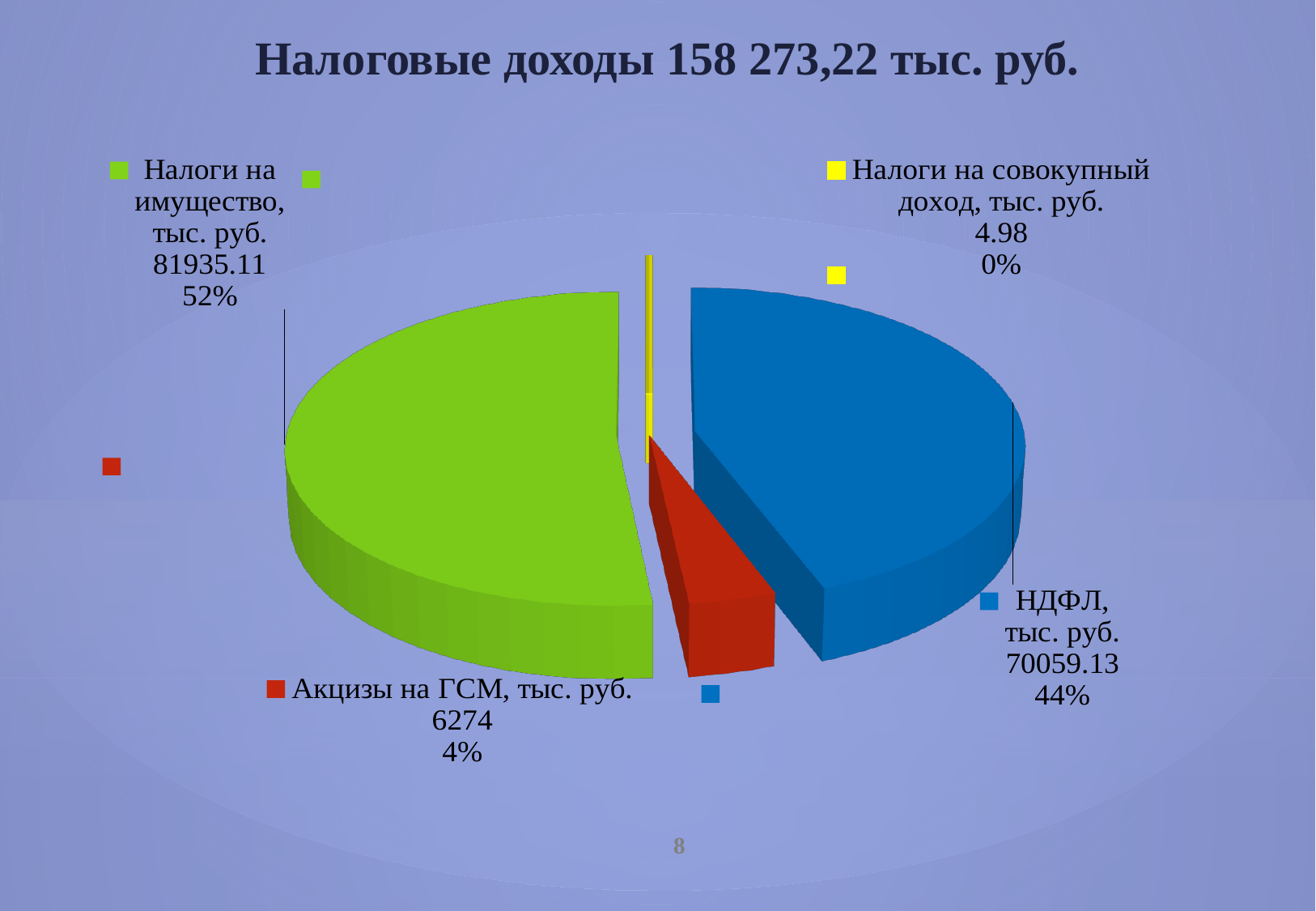
Which category has the smallest slice of the pie? Налоги на совокупный доход What is the value shown for Налоги на имущество? 81935.11 What is the title of the chart? Налоговые доходы 158 273,22 тыс. руб. What share of the pie does НДФЛ represent? 44% Which category has the largest slice of the pie? Налоги на имущество How many slices does the pie chart have? 4 What is the value shown for НДФЛ? 70059.13 What is the value shown for Акцизы на ГСМ? 6274 What kind of chart is shown on the slide? pie chart What share of the pie does Акцизы на ГСМ represent? 4% What is the value shown for Налоги на совокупный доход? 4.98 Which is larger, Налоги на имущество or НДФЛ? Налоги на имущество